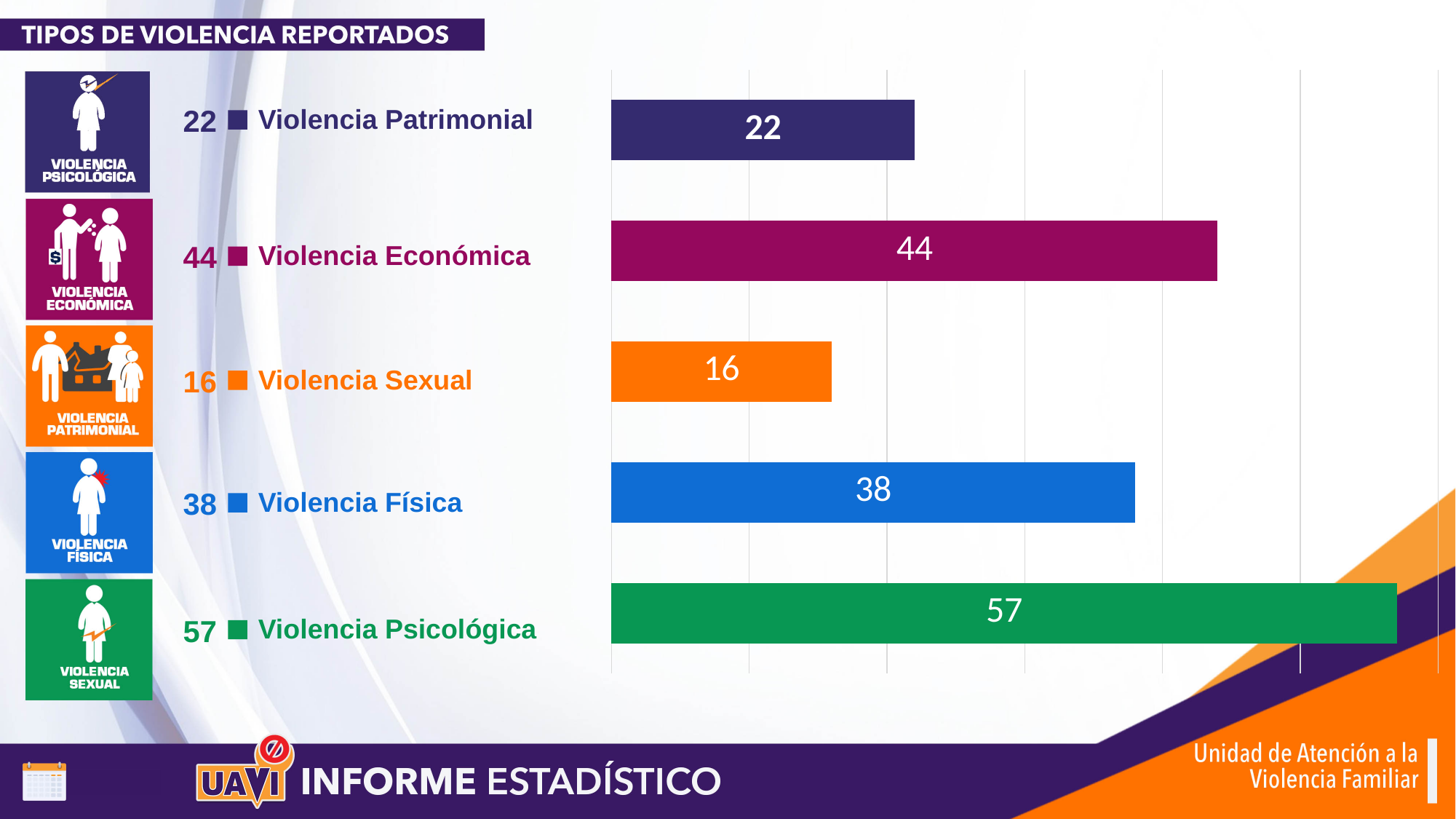
What is the value for Violencia Sexual? 16 What is the value for Violencia Patrimonial? 22 Which type of violence has the highest value? Violencia Psicológica Which type of violence has the lowest value? Violencia Sexual How many types of violence are shown in the chart? 5 What is the value for Violencia Económica? 44 What is the value for Violencia Física? 38 What is the difference between the values for Violencia Psicológica and Violencia Económica? 13 What is the difference between the values for Violencia Física and Violencia Patrimonial? 16 What is the value for Violencia Psicológica? 57 What kind of chart is shown on the slide? Bar chart Which is larger, the value for Violencia Económica or the value for Violencia Física? Violencia Económica